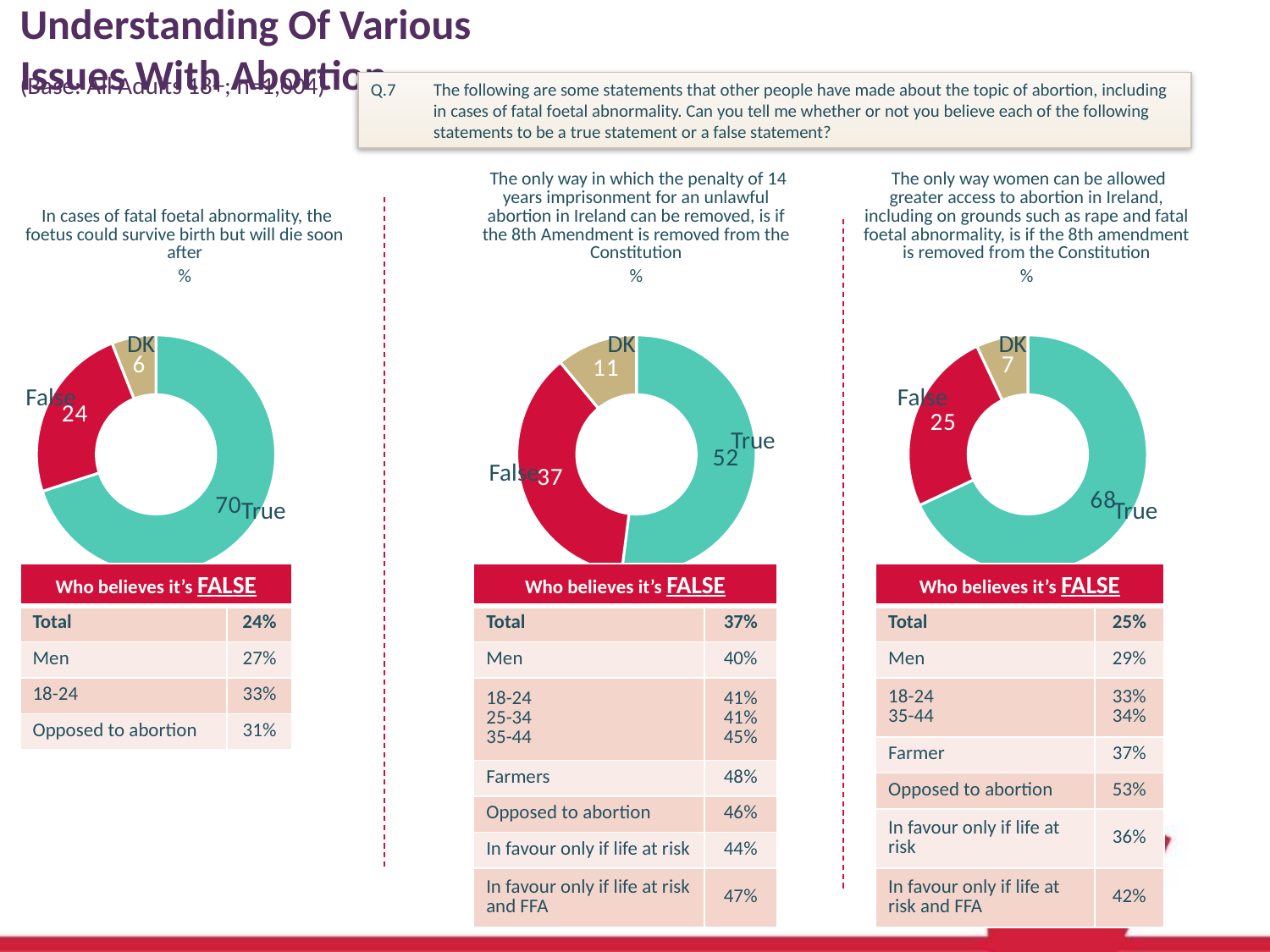
In the left donut chart (fatal foetal abnormality statement), what percentage said False? 24 In the right donut chart (greater access to abortion statement), what percentage said True? 68 In the middle donut chart (14 years imprisonment statement), what percentage said False? 37 In the middle donut chart (14 years imprisonment statement), what percentage said DK? 11 In the middle donut chart (14 years imprisonment statement), which response has the largest share? True In the right donut chart (greater access to abortion statement), which response has the smallest share? DK How many segments does each donut chart on the slide have? 3 What type of chart is used to show the True/False/DK responses on this slide? Donut (pie) chart Is the False share larger in the left donut chart or in the middle donut chart? Middle donut chart In the left donut chart (fatal foetal abnormality statement), what percentage of respondents said True? 70 In the middle donut chart (14 years imprisonment statement), what is the difference between the True and False percentages? 15 In the right donut chart (greater access to abortion statement), what is the combined percentage of False and DK? 32